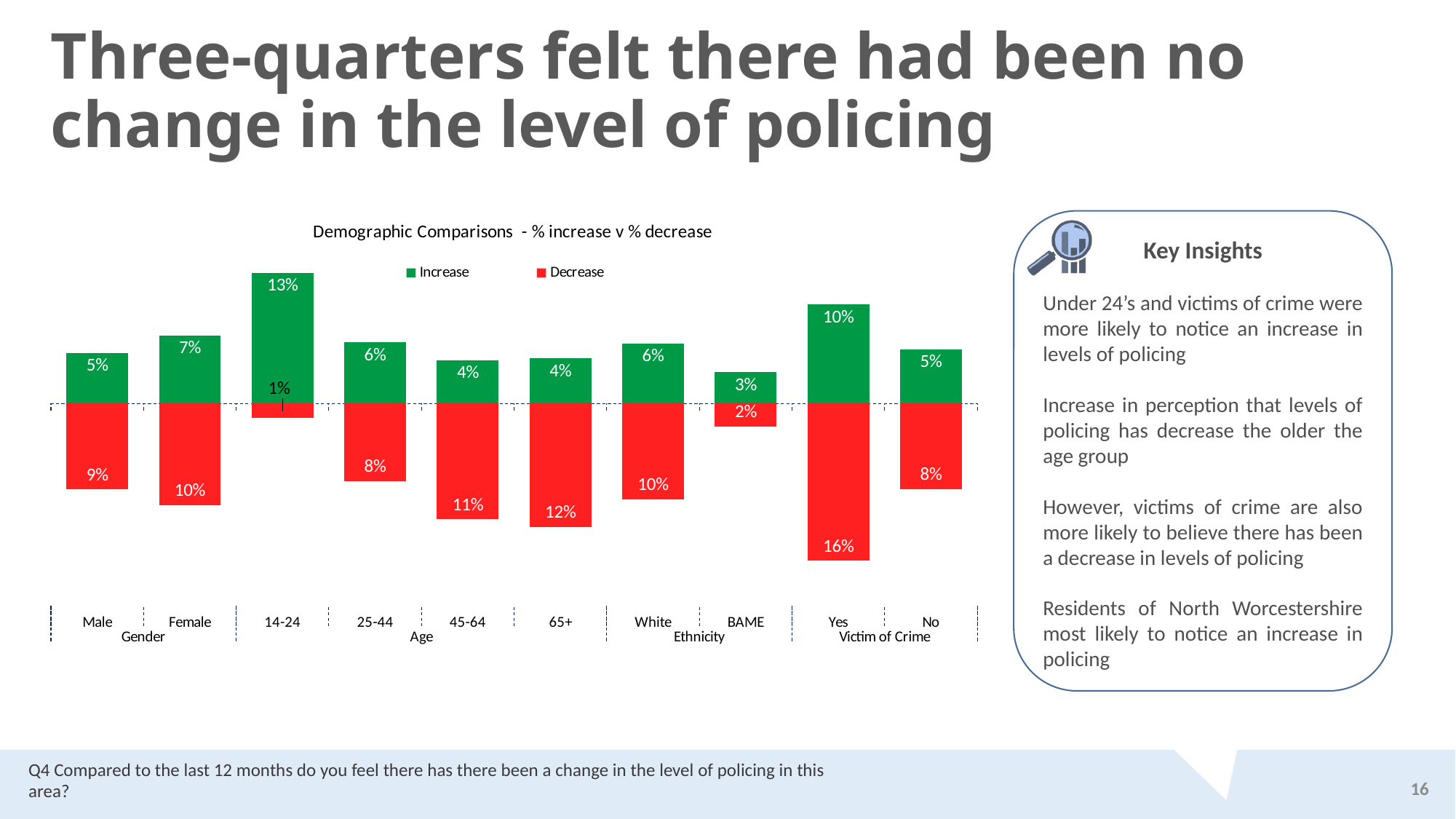
How many series does the legend list? 2 Which category has the highest Increase value? 14-24 Which category has the lowest Decrease value? 14-24 What is the Increase value for the 14-24 age group? 13% What is the Decrease value for the 65+ age group? 12% What is the Decrease value for victims of crime (Yes)? 16% What is the difference between the Decrease and Increase values for Female respondents? 3% How many demographic categories are shown on the x axis? 10 What colour represents the Decrease series in the chart? Red What type of chart is shown on the slide? Bar chart What is the Increase value for BAME respondents? 3% Which is larger for the White category, the Increase value or the Decrease value? Decrease